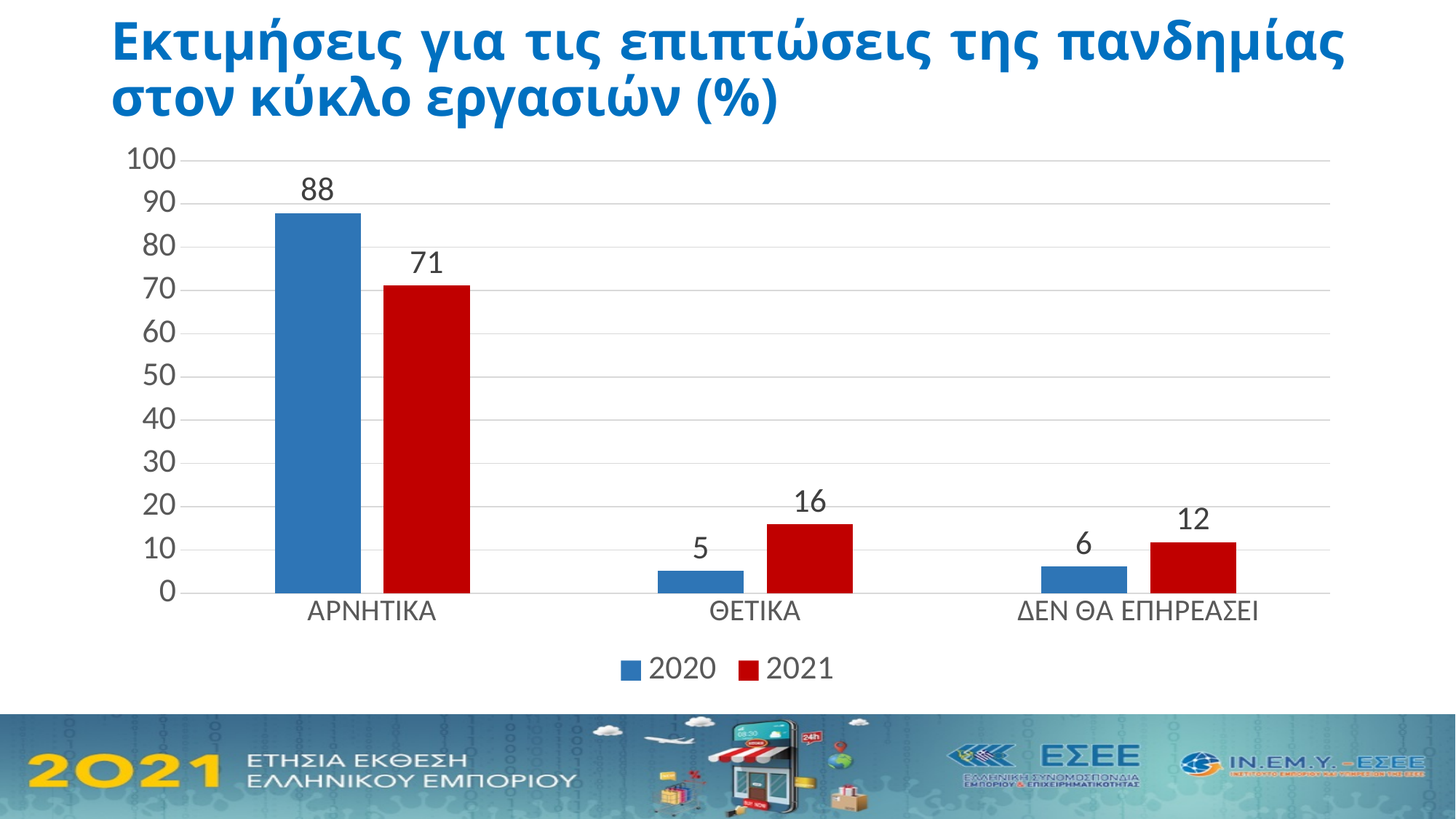
Which category has the highest value in the 2021 series? ΑΡΝΗΤΙΚΑ What is the value for ΑΡΝΗΤΙΚΑ in the 2020 series? 88 What is the difference between the 2020 and 2021 values for ΑΡΝΗΤΙΚΑ? 17 What is the value for ΔΕΝ ΘΑ ΕΠΗΡΕΑΣΕΙ in the 2020 series? 6 Which is larger for ΔΕΝ ΘΑ ΕΠΗΡΕΑΣΕΙ: the 2020 value or the 2021 value? 2021 What kind of chart is shown on the slide? bar chart Is the 2021 value for ΑΡΝΗΤΙΚΑ greater or less than 80? less What is the value for ΘΕΤΙΚΑ in the 2021 series? 16 Which category has the lowest value in the 2020 series? ΘΕΤΙΚΑ How many categories are shown on the x axis? 3 Which colour represents the 2021 series? red How many series does the legend list? 2